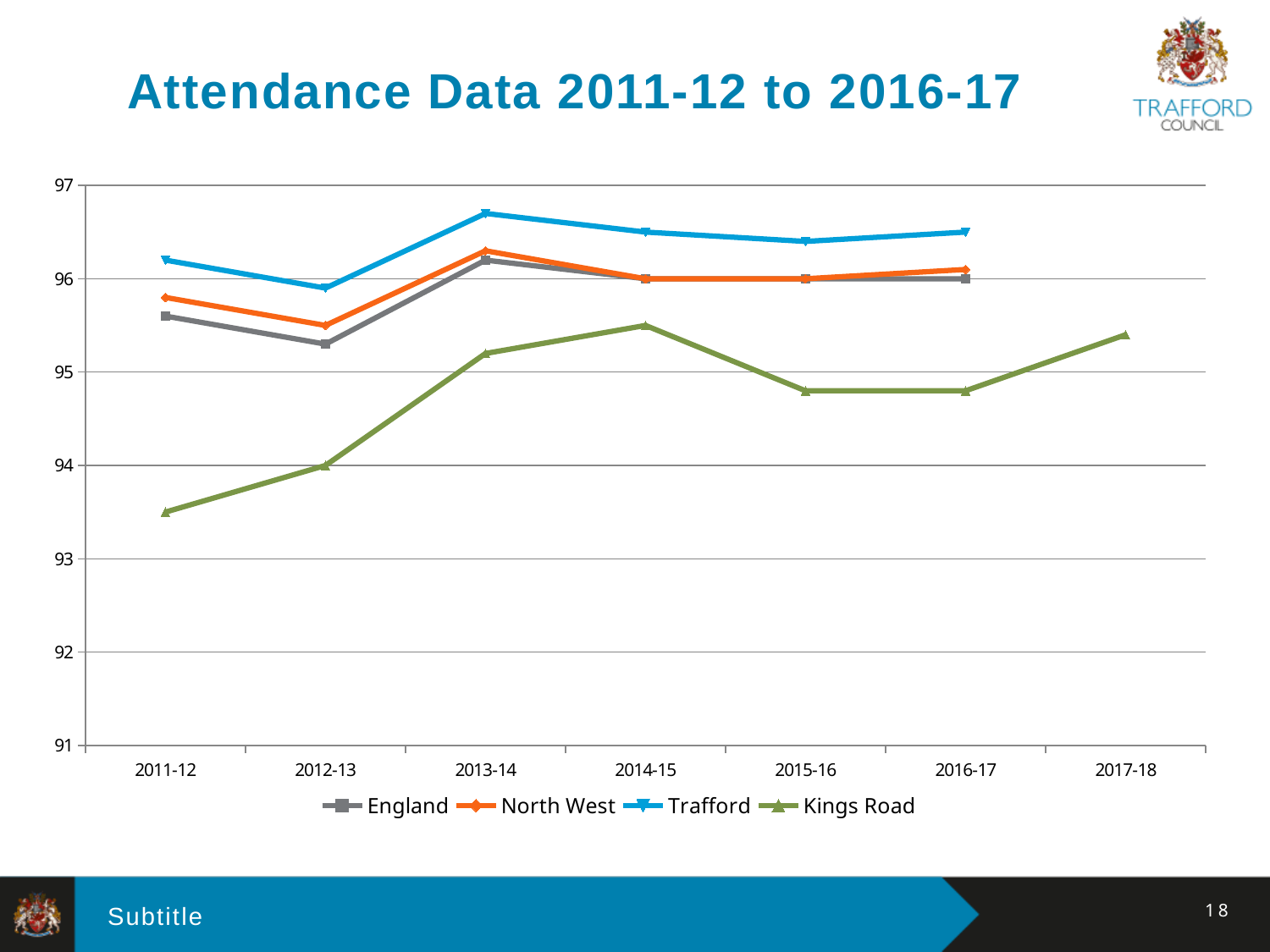
How many academic years are shown on the x axis? 7 Which series is the only one with a data point for 2017-18? Kings Road How many series does the legend list? 4 Which is larger in 2015-16, Trafford or Kings Road? Trafford What is the value for Kings Road in 2012-13? 94 Which series has the lowest value in 2011-12? Kings Road Is the value for Kings Road in 2011-12 greater or less than 94? less Do the Kings Road values rise or fall from 2011-12 to 2013-14? rise Which series has the highest value in 2013-14? Trafford Is the value for Trafford in 2013-14 greater or less than 96? greater What kind of chart is shown on the slide? line chart In which year does Kings Road reach its lowest value? 2011-12